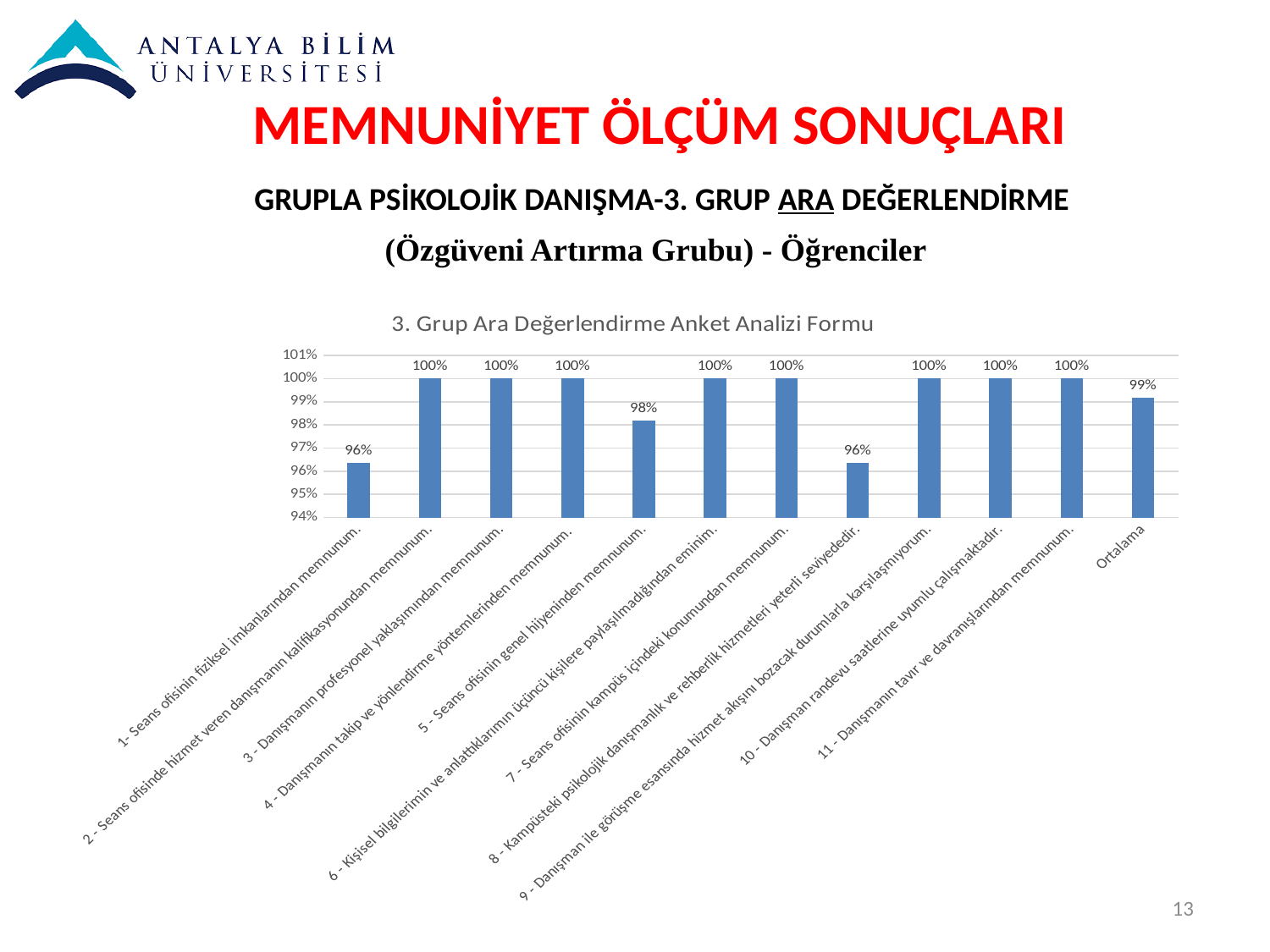
Which is larger, the value for "Ortalama" or the value for "5 - Seans ofisinin genel hijyeninden memnunum."? Ortalama What is the value for "8 - Kampüsteki psikolojik danışmanlık ve rehberlik hizmetleri yeterli seviyededir."? 96% What is the value for "5 - Seans ofisinin genel hijyeninden memnunum."? 98% Is the value for "8 - Kampüsteki psikolojik danışmanlık ve rehberlik hizmetleri yeterli seviyededir." greater or less than 98%? less What is the title of the chart? 3. Grup Ara Değerlendirme Anket Analizi Formu What is the value for "1- Seans ofisinin fiziksel imkanlarından memnunum."? 96% How many categories have a value of 100%? 8 How many categories are shown on the x axis of the chart? 12 What kind of chart is shown on the slide? bar chart What is the value for "10 - Danışman randevu saatlerine uyumlu çalışmaktadır."? 100% What is the value for "Ortalama"? 99% What is the difference between the value for "5 - Seans ofisinin genel hijyeninden memnunum." and the value for "1- Seans ofisinin fiziksel imkanlarından memnunum."? 2%